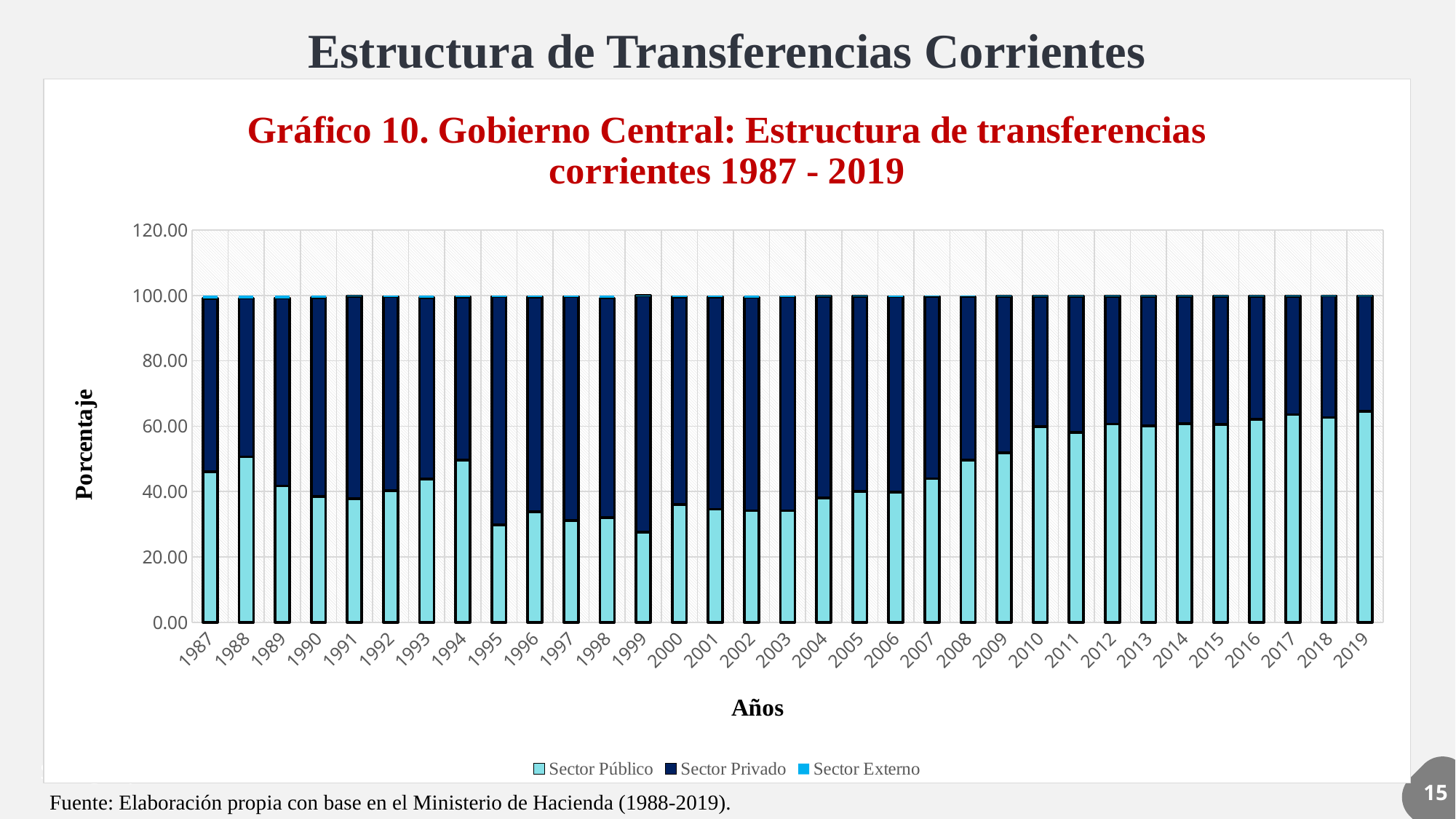
What is the label of the y axis? Porcentaje Which year has the larger Sector Público share, 1987 or 1999? 1987 Which series is shown in light blue at the bottom of each bar? Sector Público How many series does the legend list? 3 What kind of chart is shown on the slide? Stacked bar chart Which year has the larger Sector Privado share, 1999 or 2019? 1999 Is the Sector Público value for 1995 greater or less than 20? greater Does the Sector Público share rise or fall from 2007 to 2010? rise Is the Sector Público value for 1987 greater or less than 40? greater How many years are shown on the x axis? 33 Is the Sector Público value for 2019 greater or less than 60? greater